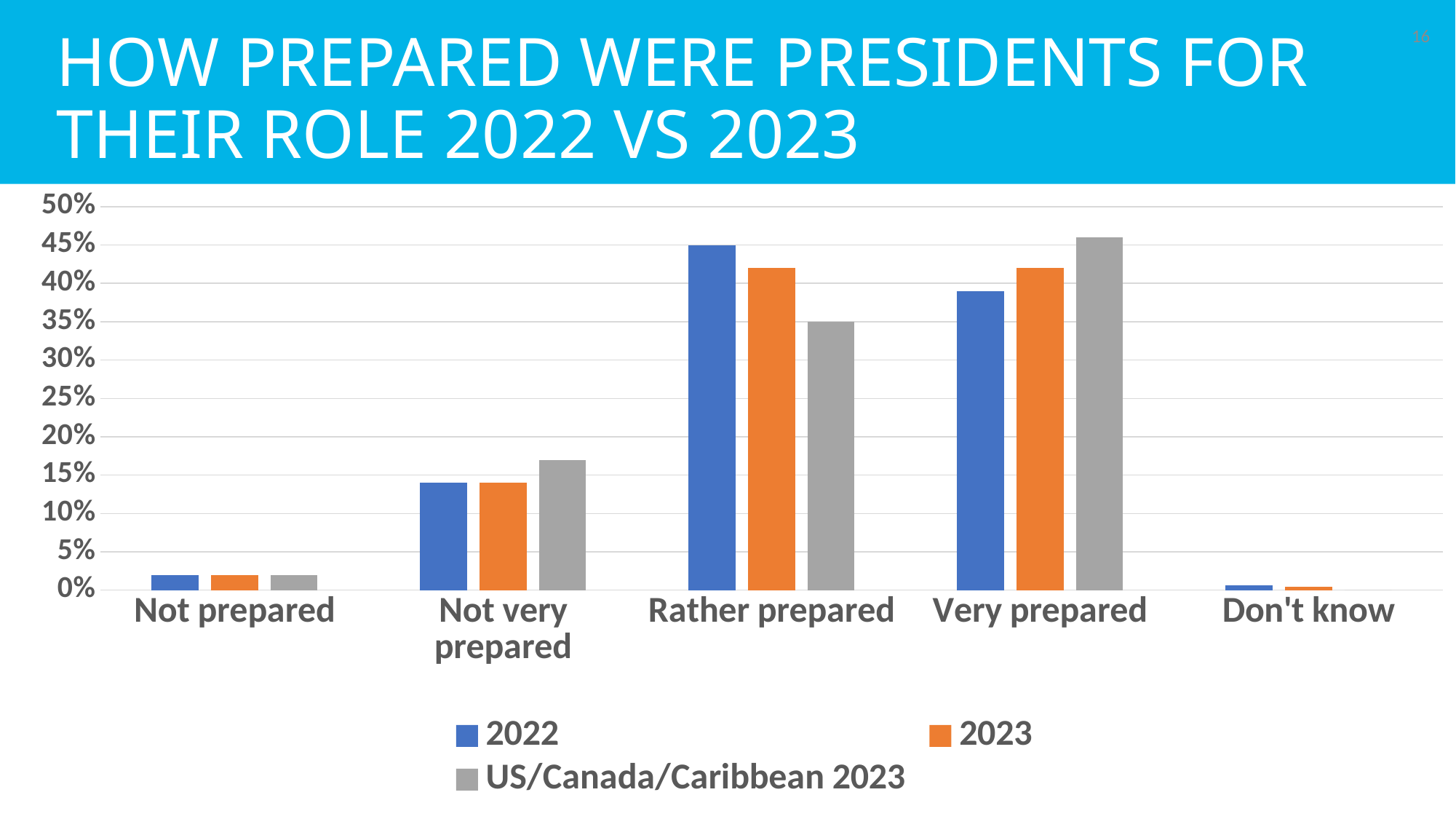
Which category has the highest value for the 2022 series? Rather prepared Is the US/Canada/Caribbean 2023 value for Not very prepared greater or less than 15%? greater What kind of chart is shown on the slide? bar chart How many series does the legend list? 3 Which category has the highest value for the US/Canada/Caribbean 2023 series? Very prepared How many categories are shown on the x axis? 5 For Rather prepared, which is larger: the 2022 value or the US/Canada/Caribbean 2023 value? 2022 For Very prepared, which is larger: the 2022 value or the US/Canada/Caribbean 2023 value? US/Canada/Caribbean 2023 What is the third series listed in the legend? US/Canada/Caribbean 2023 Is the 2023 value for Rather prepared greater or less than 40%? greater Is the 2022 value for Not prepared greater or less than 5%? less Which category has the lowest values across all three series? Don't know